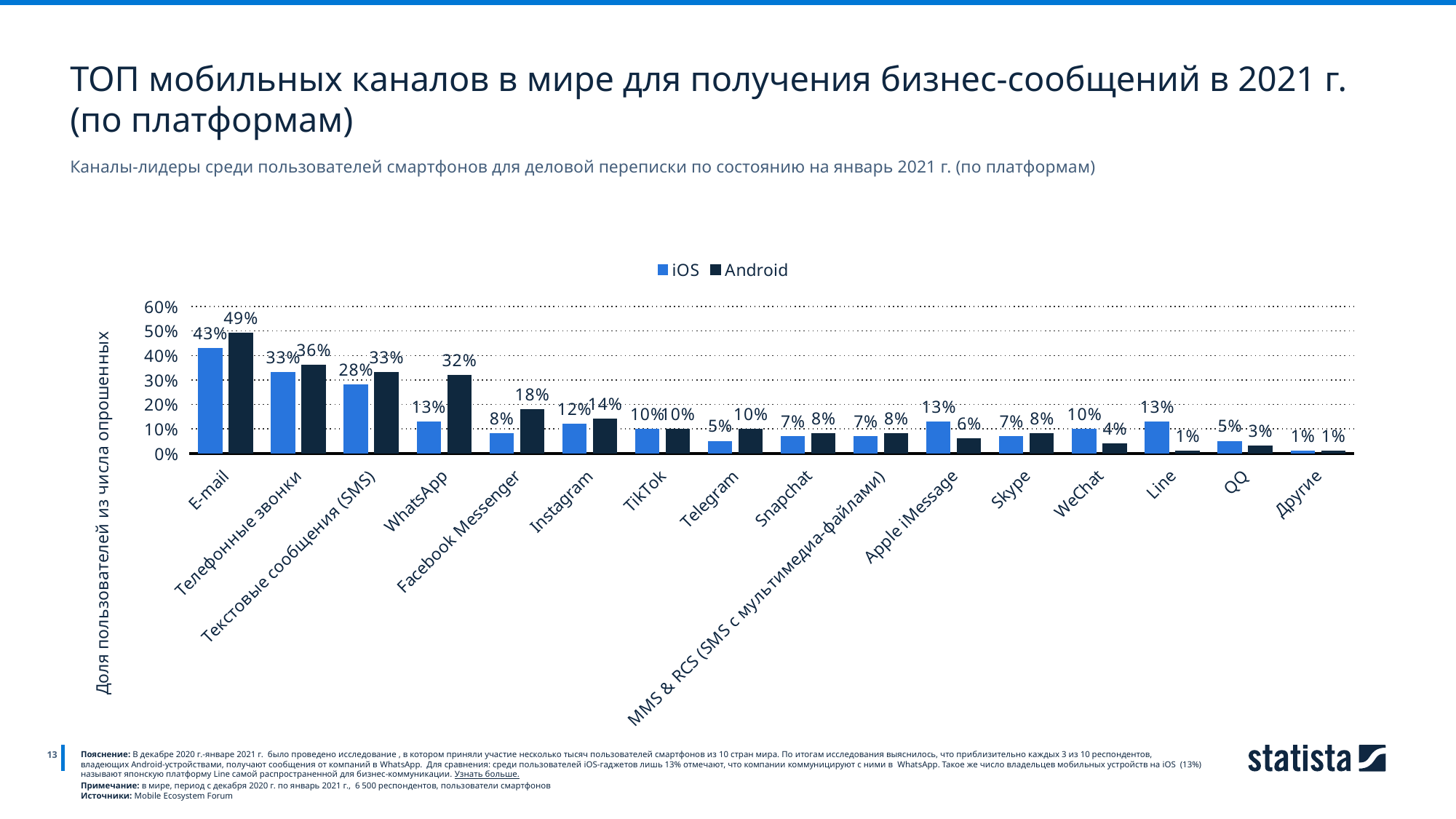
What is the iOS value for WhatsApp? 13% What is the difference between the Android and iOS values for WhatsApp? 19% What is the Android value for E-mail? 49% How many series does the legend list? 2 Is the iOS value for E-mail greater or less than 40%? greater Which is larger for Apple iMessage, the iOS value or the Android value? iOS How many categories are shown on the x axis? 16 What is the iOS value for Line? 13% Which series is shown in dark navy in the legend? Android What kind of chart is shown on the slide? Bar chart Which category has the highest Android value? E-mail What is the Android value for Facebook Messenger? 18%